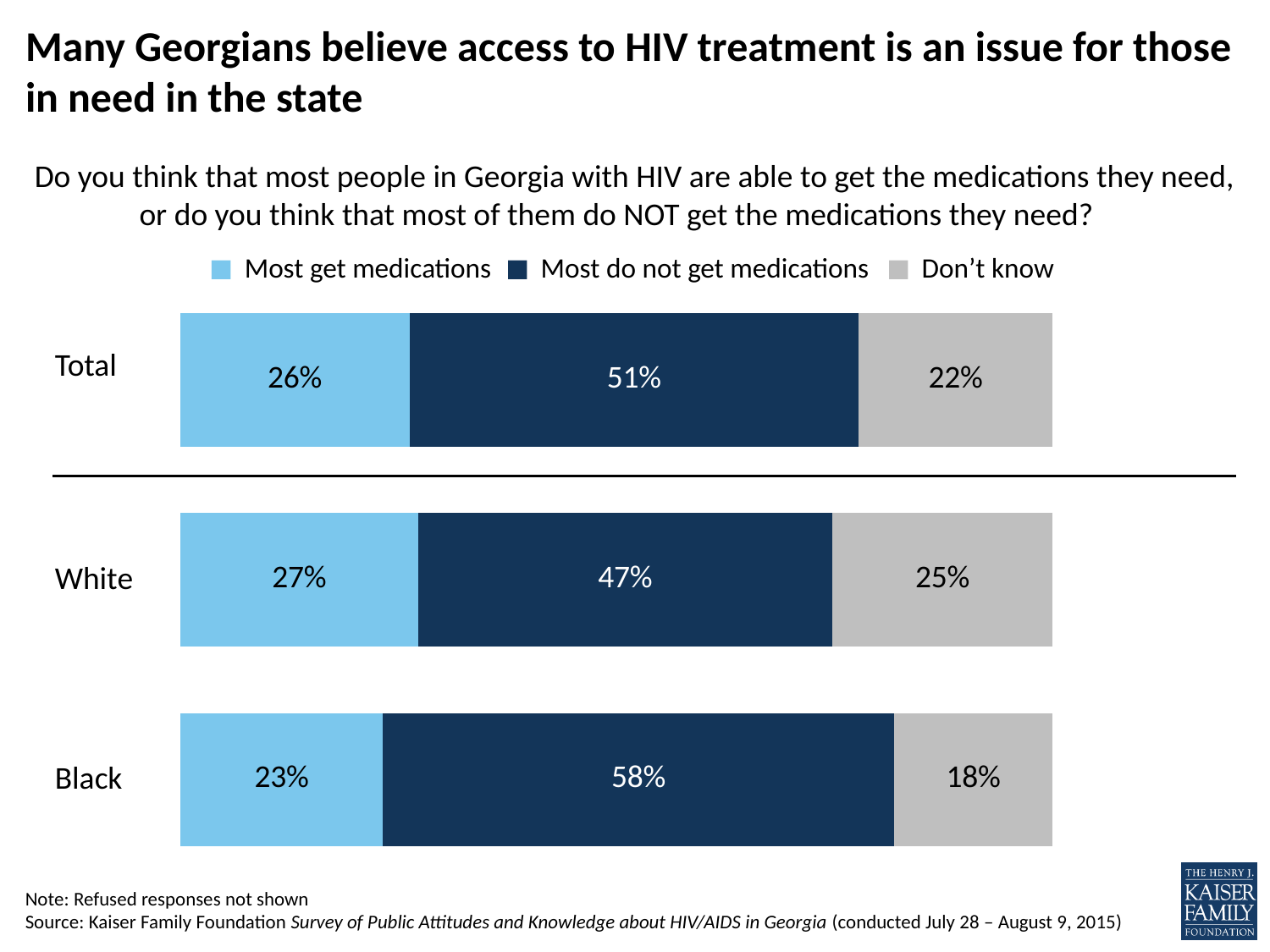
What percentage of the Total group say most people in Georgia with HIV get the medications they need? 26% Which group has the lowest share saying most get medications? Black Which group has the highest share saying most do not get medications? Black What percentage of White respondents say most do not get medications? 47% What kind of chart is shown on the slide? Stacked bar chart Which colour represents "Most do not get medications" in the legend? Dark blue Which is larger: the "Don't know" share for White respondents or for Black respondents? White How many groups (bars) are shown in the chart? 3 What is the difference between the Black and White shares saying most do not get medications? 11 percentage points What is the total of the three labeled segments in the Total bar? 99% What percentage of Black respondents answered "Don't know"? 18% How many response categories does the legend list? 3